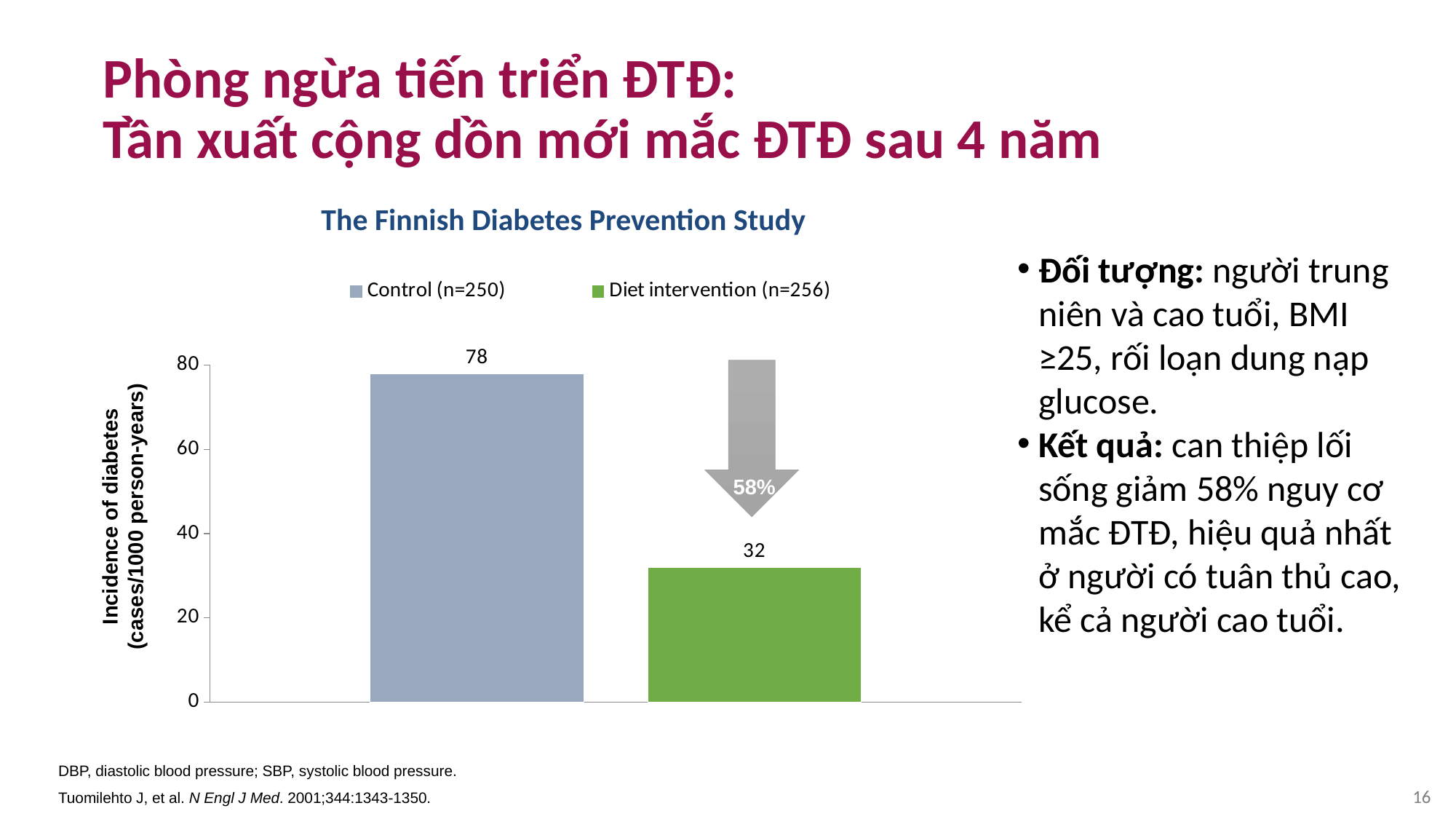
What is the incidence of diabetes for the Control (n=250) group? 78 What percentage reduction is indicated by the arrow on the chart? 58% What is the difference in incidence of diabetes between the Control and Diet intervention groups? 46 What is the incidence of diabetes for the Diet intervention (n=256) group? 32 Which group has the higher incidence of diabetes? Control (n=250) Is the value for the Control group greater or less than 60? greater How many series does the legend list? 2 How many bars are plotted in the chart? 2 Which group has the lower incidence of diabetes? Diet intervention (n=256) Is the incidence of diabetes higher for the Control group or the Diet intervention group? Control group What kind of chart is shown on the slide? Bar chart Is the value for the Diet intervention group greater or less than 40? less